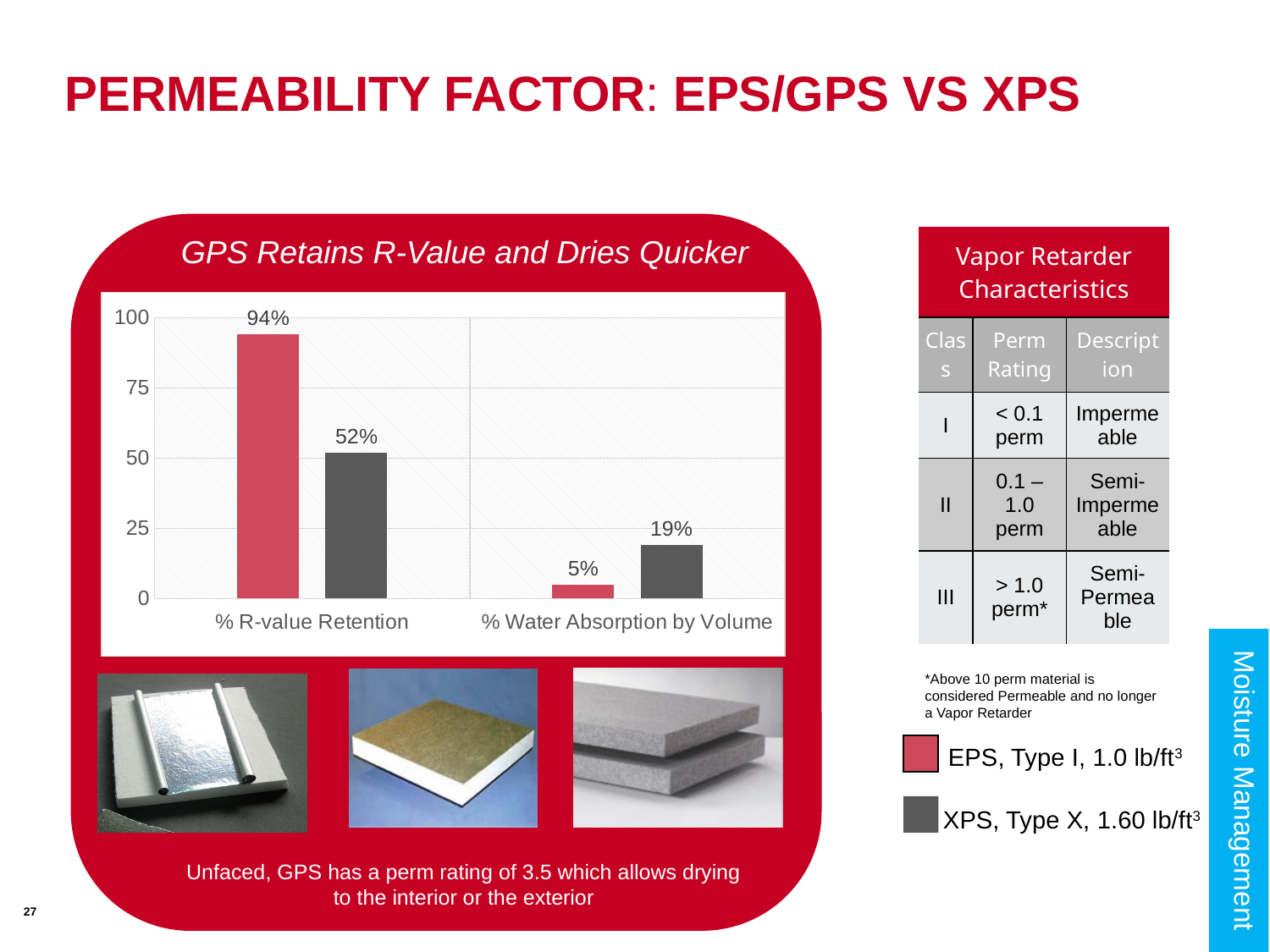
What is the % R-value Retention value for EPS? 94% Is the % R-value Retention for XPS greater or less than 50? greater How many categories are shown on the x axis of the chart? 2 What is the % R-value Retention value for XPS? 52% Which material has the higher % R-value Retention, EPS or XPS? EPS What is the % Water Absorption by Volume value for XPS? 19% Which material has the lower % Water Absorption by Volume? EPS What type of chart is shown on the slide? Bar chart What is the difference in % R-value Retention between EPS and XPS? 42% What is the % Water Absorption by Volume value for EPS? 5% What is the title of the chart? GPS Retains R-Value and Dries Quicker What is the difference in % Water Absorption by Volume between XPS and EPS? 14%